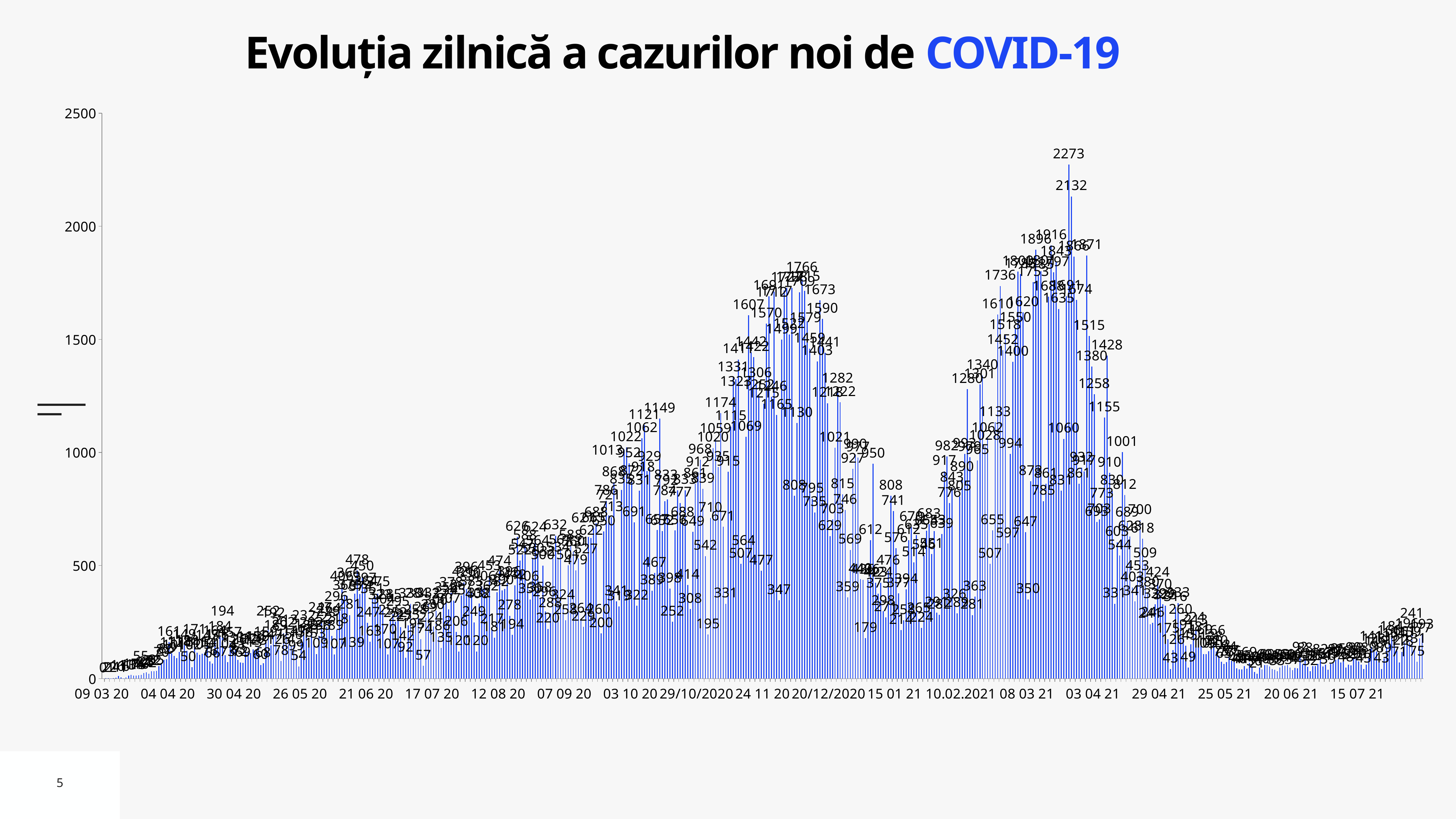
What is the title of the chart? Evoluția zilnică a cazurilor noi de COVID-19 Is the highest bar on the chart greater or less than 2000? greater What is the difference between the two highest labelled values, 2273 and 2132? 141 Do the values generally rise or fall between the x-axis labels 09 03 20 and 24 11 20? rise Do the values generally rise or fall between the x-axis labels 03 04 21 and 20 06 21? fall Is the value at the x-axis label 15 07 21 greater or less than 500? less How many date labels are printed along the x axis? 20 What is the highest daily value shown on the chart? 2273 What is the maximum value shown on the vertical axis? 2500 Which is larger, the peak value 2273 or the peak value 1766? 2273 What kind of chart is shown on the slide? bar chart What is the second-highest labelled value on the chart? 2132